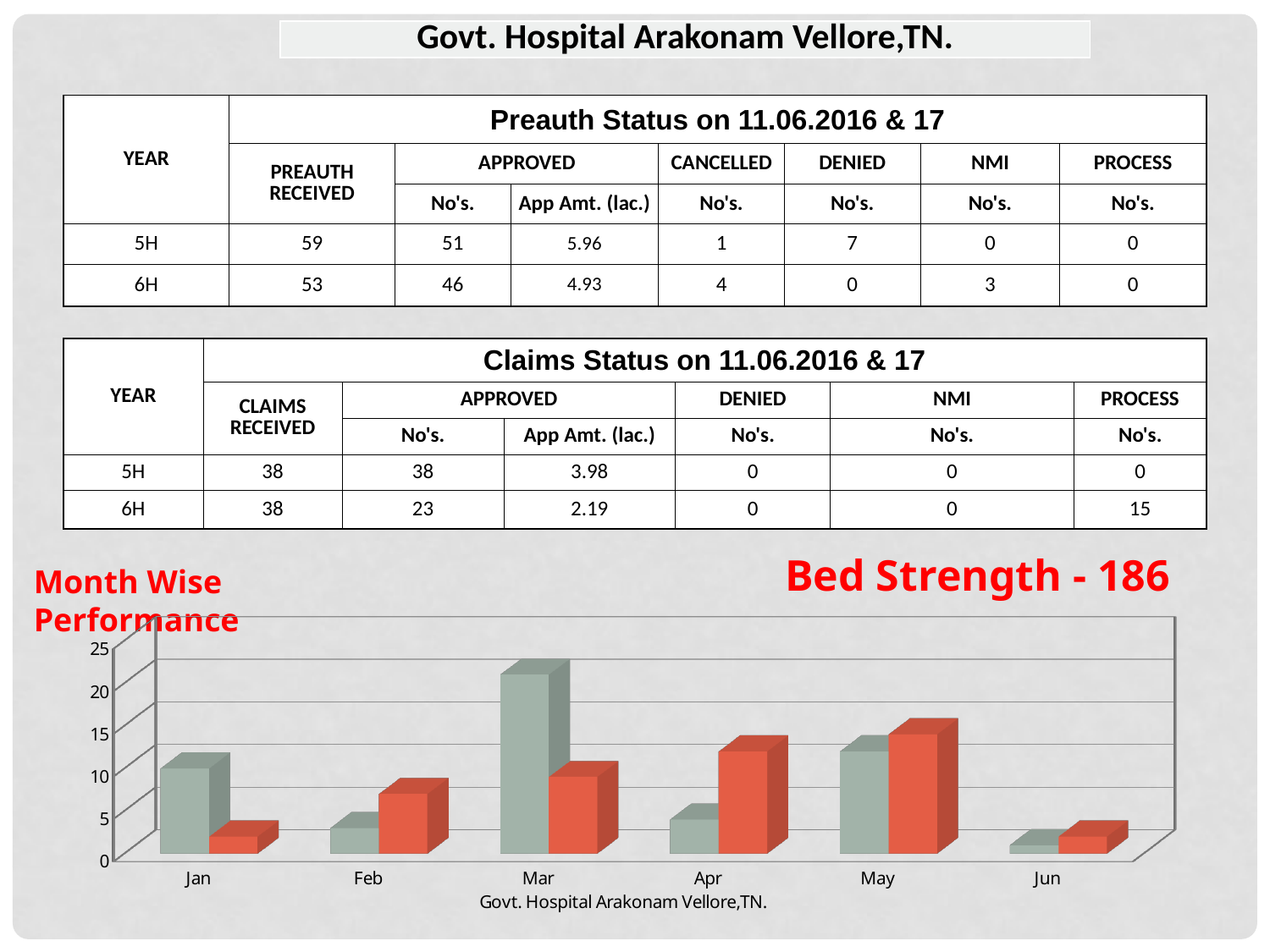
In the Month Wise Performance chart, which month has the shortest grey bar? Jun Is the red bar for Apr in the Month Wise Performance chart greater or less than 10? greater In the Month Wise Performance chart, which month has the tallest red bar? May Is the red bar for Jan in the Month Wise Performance chart greater or less than 5? less What is the highest value shown on the vertical axis of the Month Wise Performance chart? 25 Is the grey bar for Mar in the Month Wise Performance chart greater or less than 15? greater How many months are shown on the x axis of the Month Wise Performance chart? 6 In the Month Wise Performance chart, which month has the tallest grey bar? Mar In the Month Wise Performance chart, which is taller for Jan: the grey bar or the red bar? the grey bar In the Month Wise Performance chart, which is taller for Feb: the grey bar or the red bar? the red bar What kind of chart is shown under "Month Wise Performance"? bar chart